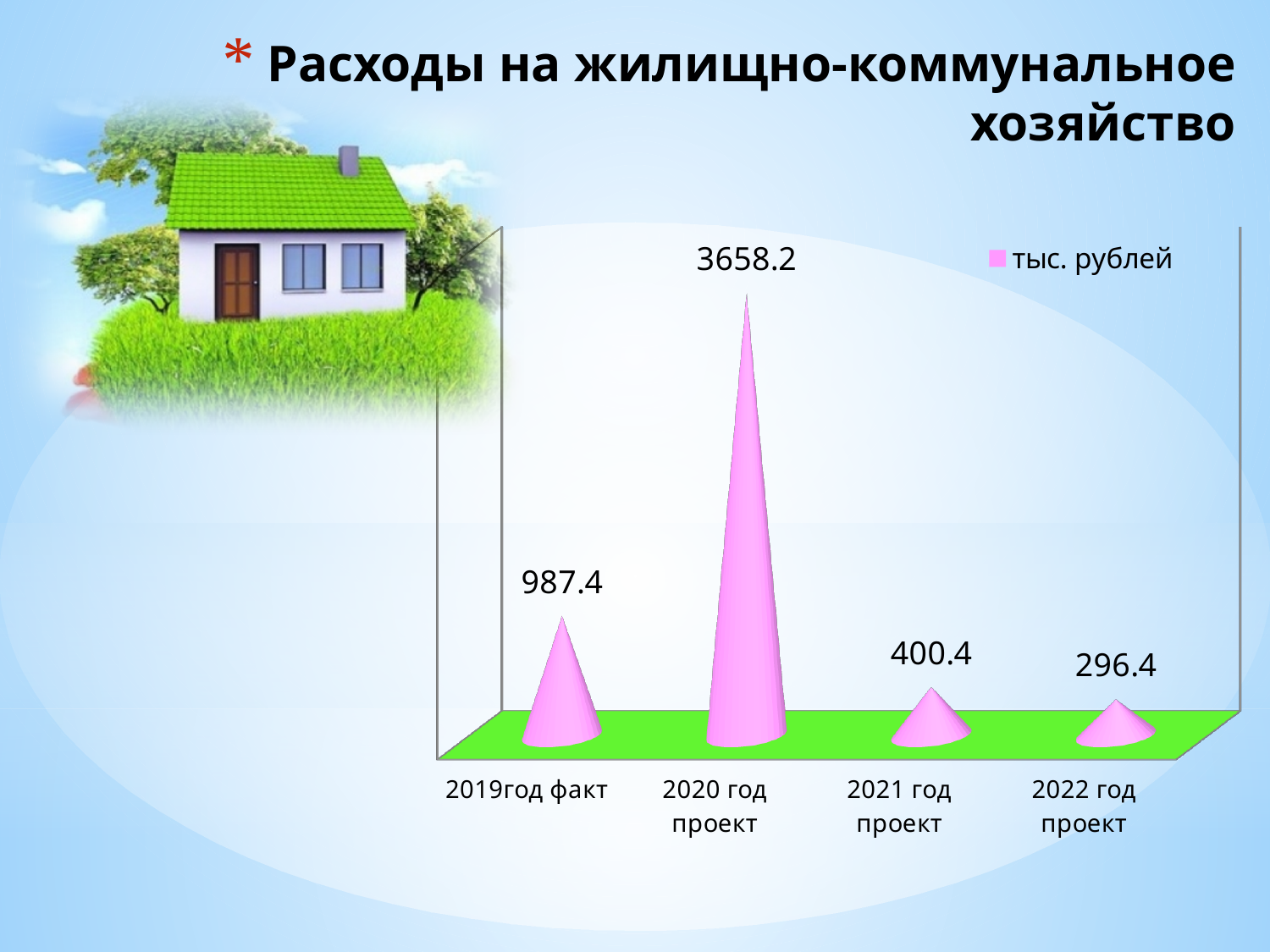
Which category has the highest value? 2020 год проект What is the value for 2021 год проект? 400.4 How many categories are shown on the x axis? 4 What is the difference between the values for 2020 год проект and 2019 год факт? 2670.8 What is the value for 2020 год проект? 3658.2 What is the difference between the values for 2021 год проект and 2022 год проект? 104 What is the value for 2022 год проект? 296.4 Which is larger, the value for 2019 год факт or the value for 2021 год проект? 2019 год факт What is the value for 2019 год факт? 987.4 Which category has the lowest value? 2022 год проект What unit does the legend give for the plotted values? тыс. рублей How many series does the legend list? 1